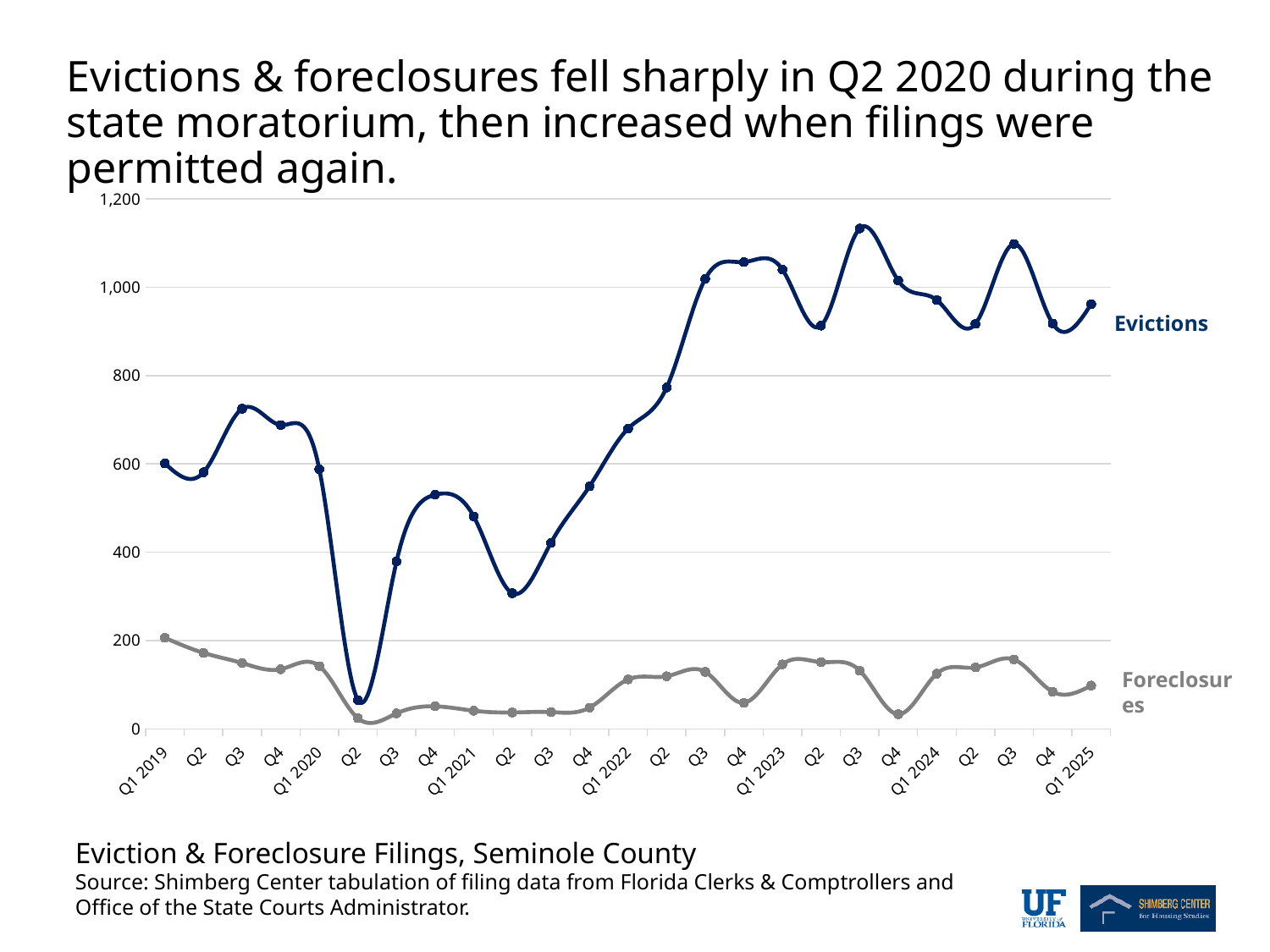
Is the Evictions value for Q2 2020 greater or less than 200? less Is the Foreclosures value for Q1 2025 greater or less than 200? less How many series are plotted on the chart? 2 What is the title of the chart shown below the plot? Eviction & Foreclosure Filings, Seminole County Is the Evictions value for Q3 2023 greater or less than 1,000? greater How many quarterly data points does each line have, from Q1 2019 to Q1 2025? 25 In which quarter is the Evictions line at its lowest? Q2 2020 What colour is the Evictions line? dark blue What kind of chart is shown on the slide? line chart Which series has the larger value in Q1 2019, Evictions or Foreclosures? Evictions Do Evictions rise or fall between Q1 2022 and Q3 2022? rise